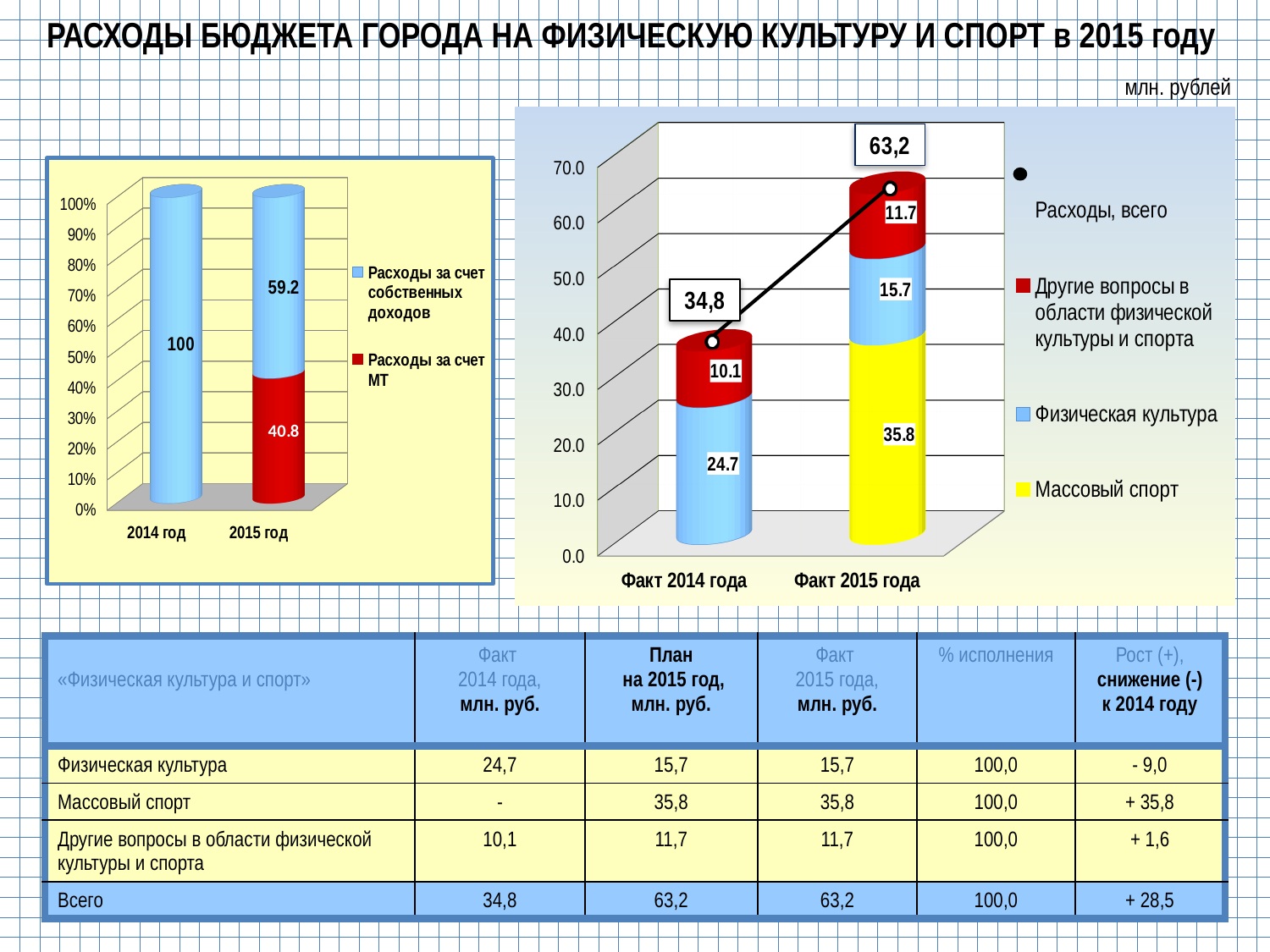
In the left chart, what is the value for 'Расходы за счет МТ' for 2015 год? 40.8 In the right chart, what is the value for 'Массовый спорт' for Факт 2015 года? 35.8 In the left chart, what is the value for 'Расходы за счет собственных доходов' for 2015 год? 59.2 In the right chart, what is the value for 'Физическая культура' for Факт 2014 года? 24.7 In the right chart, what is the total 'Расходы, всего' for Факт 2014 года? 34,8 In the right chart, which is larger: 'Другие вопросы в области физической культуры и спорта' for Факт 2014 года or for Факт 2015 года? Факт 2015 года In the left chart, how many series does the legend list? 2 In the right chart, what is the difference between 'Физическая культура' for Факт 2014 года and Факт 2015 года? 9.0 In the left chart, what is the value for 'Расходы за счет собственных доходов' for 2014 год? 100 In the right chart, what is the value for 'Другие вопросы в области физической культуры и спорта' for Факт 2015 года? 11.7 In the right chart, what is the total 'Расходы, всего' for Факт 2015 года? 63,2 What kind of chart is the right chart? Stacked bar chart with a line